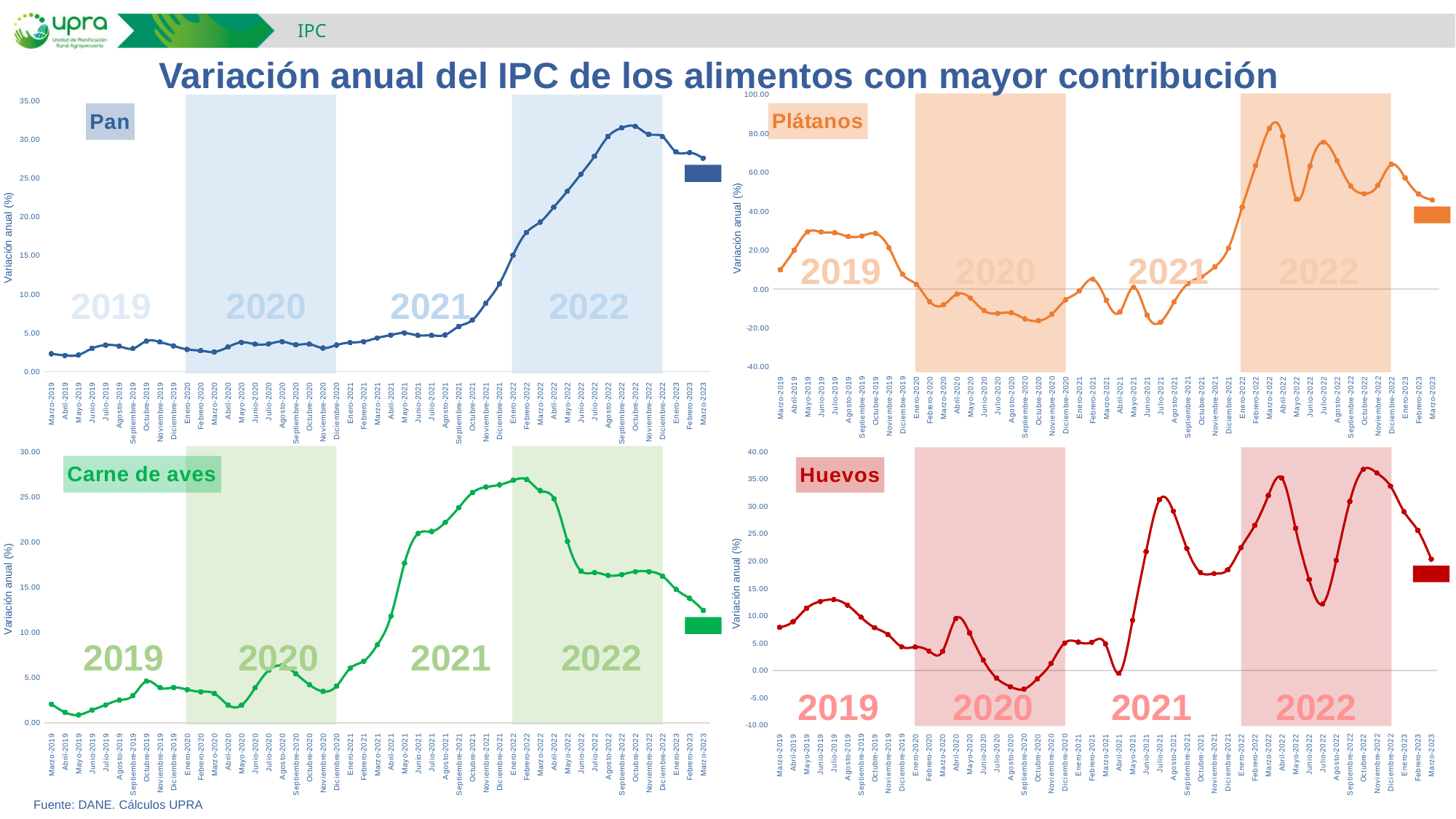
In the Huevos chart, is the value for Agosto-2020 greater or less than 0? less In the Carne de aves chart, is the value for Marzo-2023 greater or less than 15? less In the Plátanos chart, which month has the highest value? Marzo-2022 In the Pan chart, do the values rise or fall from Enero-2022 to Octubre-2022? rise In the Carne de aves chart, which month has the lowest value? Mayo-2019 How many charts are shown on the slide? 4 In the Pan chart, is the value for Marzo-2019 greater or less than 5? less What kind of chart is the Pan chart? line chart In the Huevos chart, which is larger, the value for Marzo-2019 or the value for Marzo-2023? Marzo-2023 Which food is shown in the bottom-right chart? Huevos